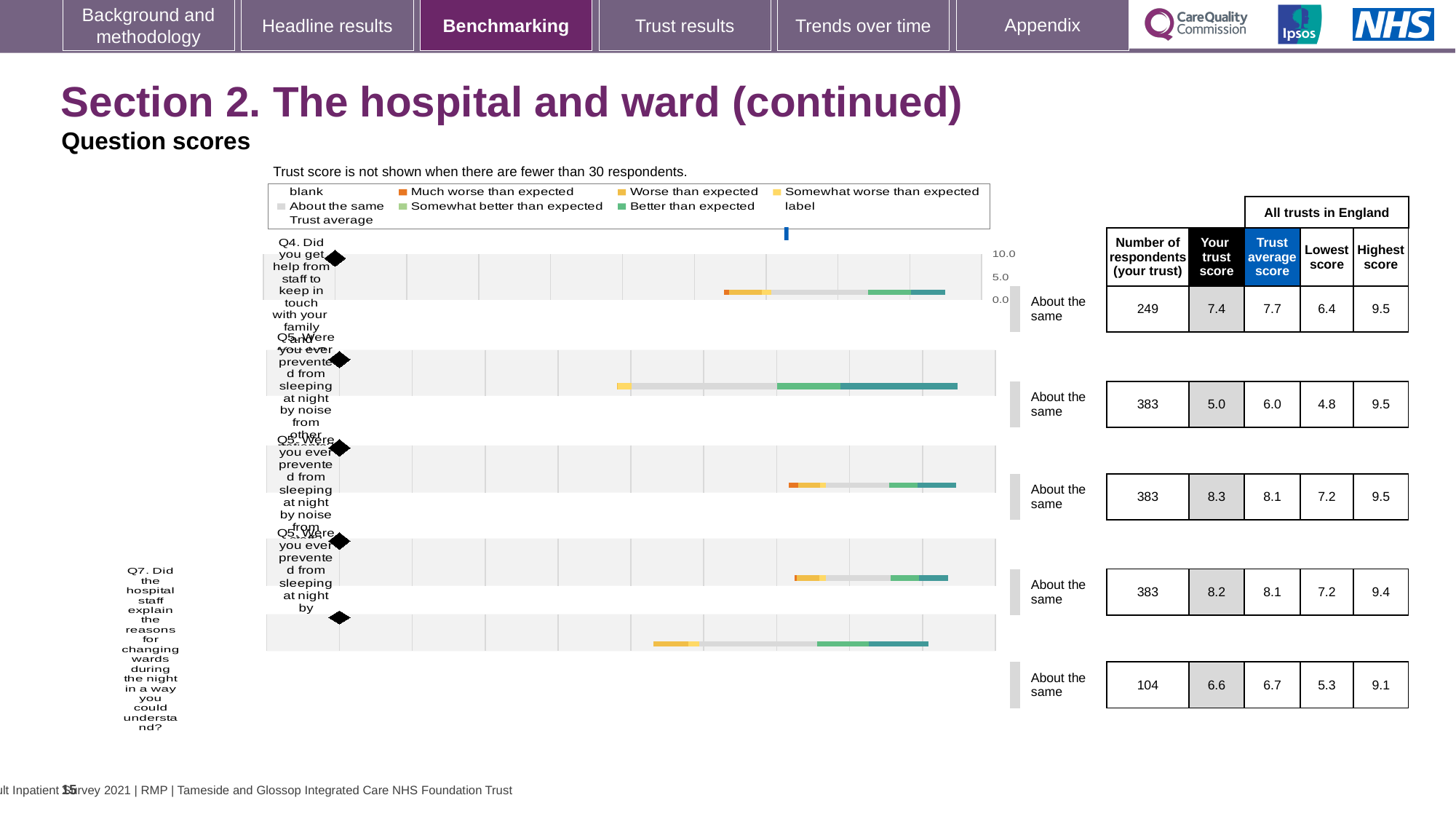
Is the trust score for the first row (Q4) larger or smaller than its trust average score? smaller What kind of chart is used to show the question scores on this slide? bar chart Which row has the highest 'Your trust score' value? the third row (8.3) What is the highest score across all trusts in England for the bottom row (Q7)? 9.1 Which row has the lowest 'Your trust score' value? the second row (5.0) What is the trust score for the first row (Q4, help from staff to keep in touch with family)? 7.4 What is the trust average score for the first row (Q4)? 7.7 What benchmark category is shown for every row in the chart? About the same How many question rows (bars) are plotted in the chart? 5 What is the number of respondents for the bottom row (Q7, explaining reasons for changing wards during the night)? 104 What is the trust score for the bottom row (Q7)? 6.6 What is the difference between the trust average score and the trust score for the second row (6.0 vs 5.0)? 1.0